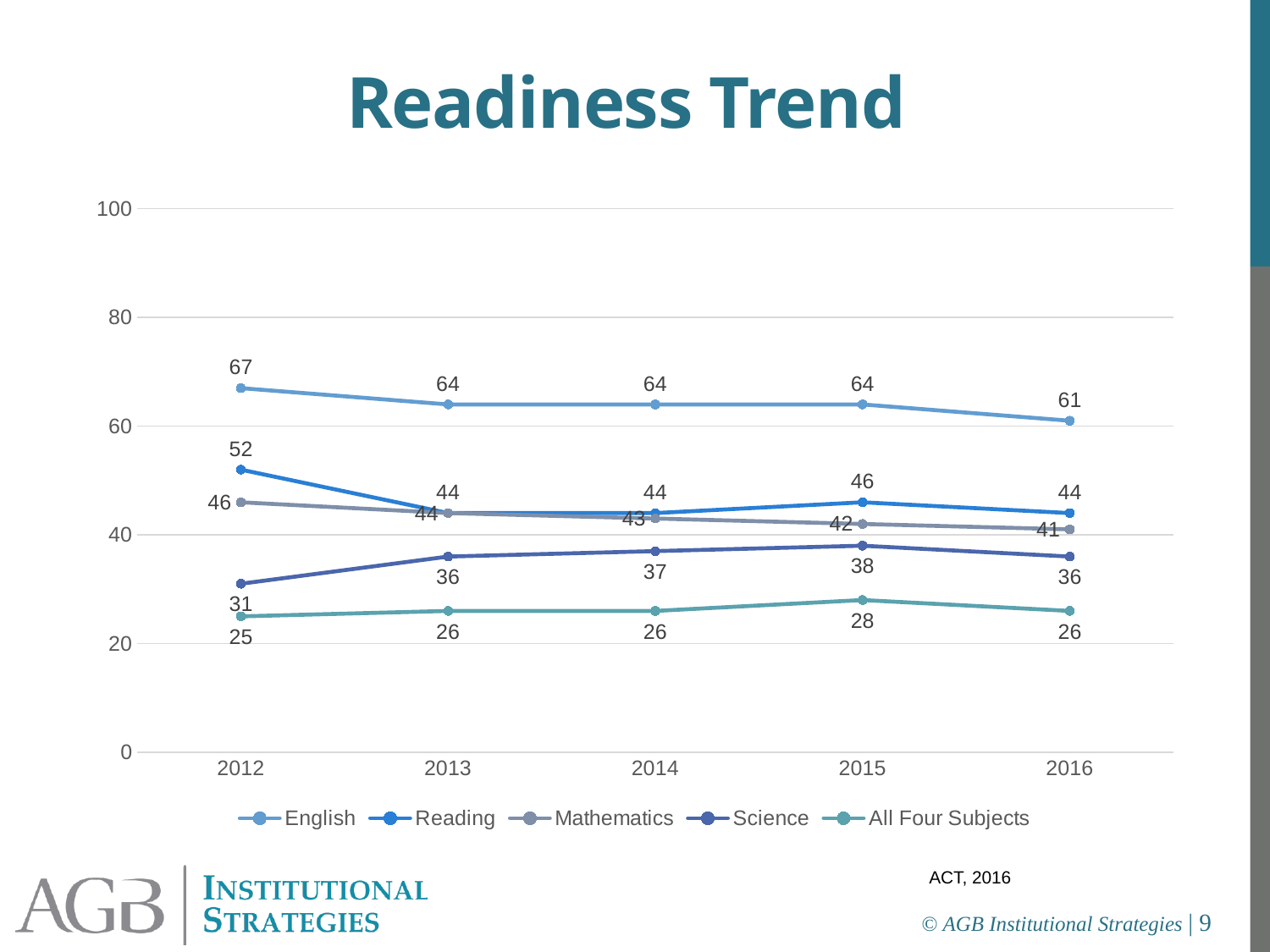
Which is larger in 2013, the Science value or the All Four Subjects value? Science Does the Mathematics line rise or fall from 2012 to 2016? fall What is the value for Mathematics in 2016? 41 What is the value for All Four Subjects in 2015? 28 How many series does the legend list? 5 What kind of chart is shown on the slide? line chart Which series has the lowest value in 2012? All Four Subjects How many years are shown on the x axis? 5 What is the value for English in 2012? 67 What is the difference between the English value in 2012 and the English value in 2016? 6 Which series has the highest value in 2016? English What is the value for Reading in 2015? 46